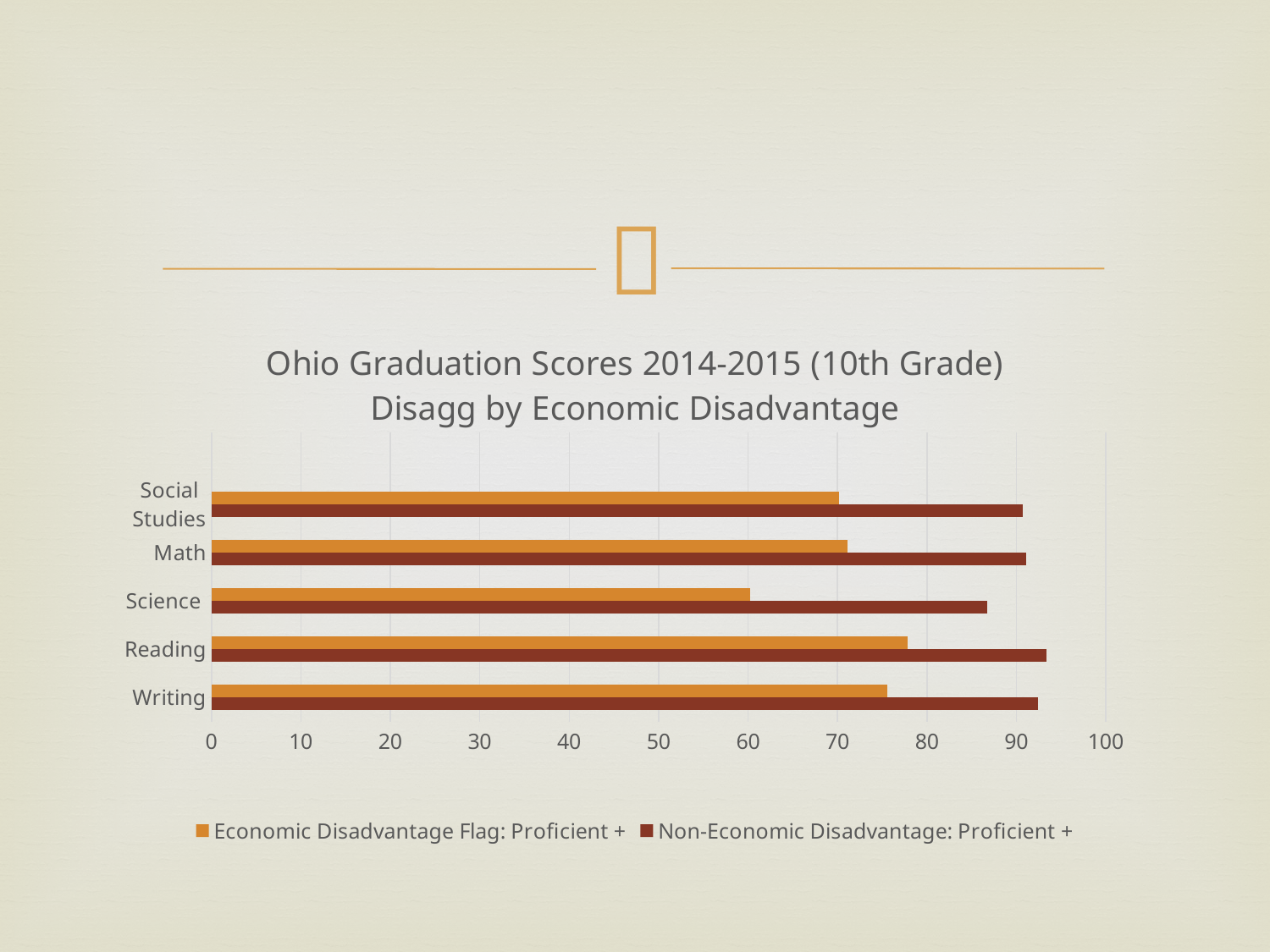
Which subject has the lowest value for the Economic Disadvantage Flag: Proficient + series? Science Is the Non-Economic Disadvantage: Proficient + value for Science greater or less than 90? less Which subject has the highest value for the Economic Disadvantage Flag: Proficient + series? Reading For Math, which series has the larger value: Economic Disadvantage Flag: Proficient + or Non-Economic Disadvantage: Proficient +? Non-Economic Disadvantage: Proficient + Is the Economic Disadvantage Flag: Proficient + value for Science greater or less than 70? less What kind of chart is shown on the slide? bar chart What is the title of the chart? Ohio Graduation Scores 2014-2015 (10th Grade) Disagg by Economic Disadvantage Is the Economic Disadvantage Flag: Proficient + value for Reading greater or less than 70? greater How many subject categories are plotted on the chart? 5 Which subject has the lowest value for the Non-Economic Disadvantage: Proficient + series? Science How many series does the legend list? 2